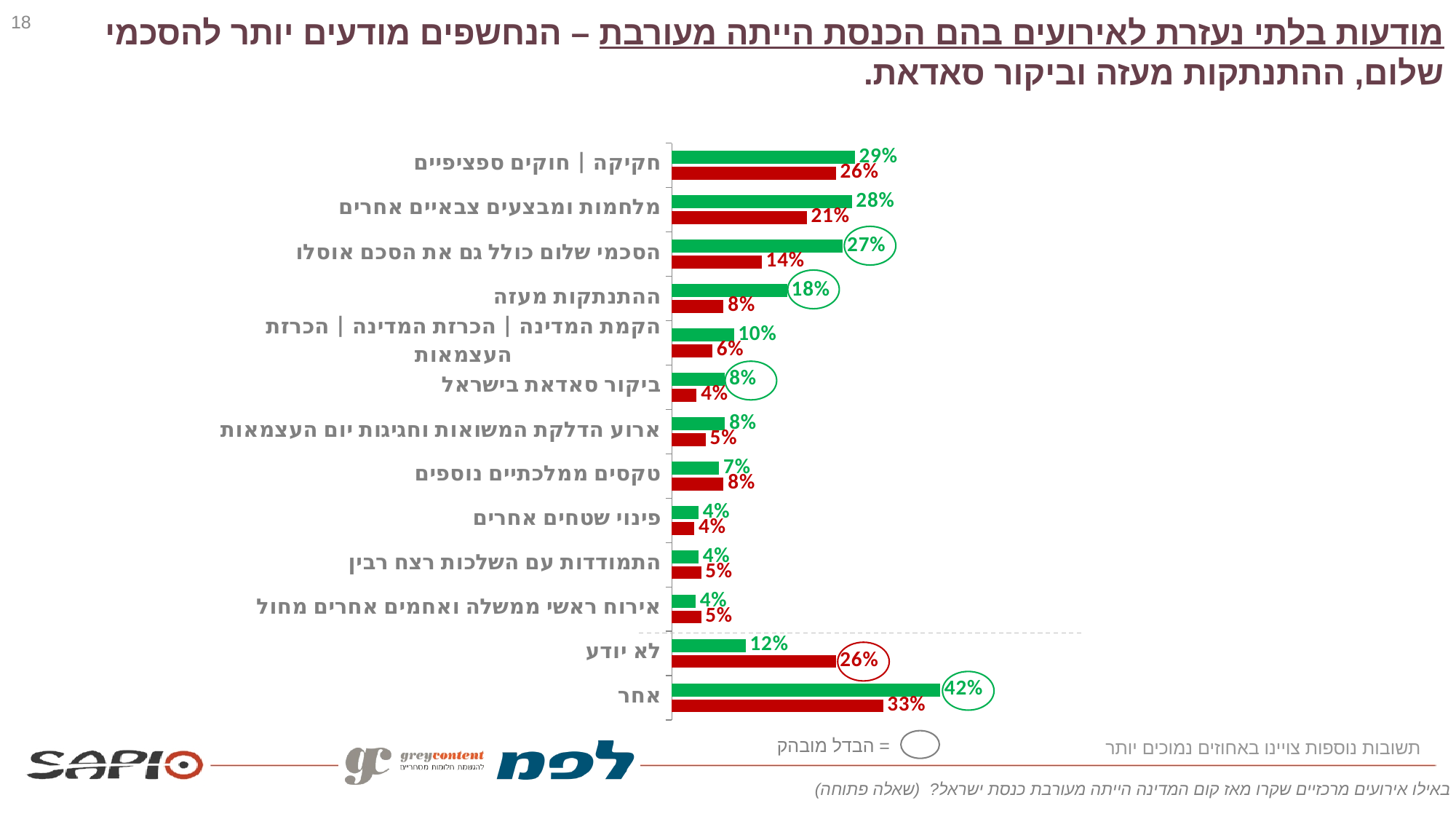
How many categories are shown in the chart? 13 For "לא יודע", which bar is larger, the green or the red? red What is the value of the red bar for "לא יודע"? 26% What is the difference between the green and red bar values for "מלחמות ומבצעים צבאיים אחרים"? 7% For "טקסים ממלכתיים נוספים", which bar is larger, the green or the red? red What type of chart is shown on the slide? bar chart What is the value of the red bar for "ההתנתקות מעזה"? 8% What is the difference between the green and red bar values for "הסכמי שלום כולל גם את הסכם אוסלו"? 13% What is the value of the green bar for "ביקור סאדאת בישראל"? 8% What is the value of the green bar for "הסכמי שלום כולל גם את הסכם אוסלו"? 27% What is the value of the green bar for "חקיקה | חוקים ספציפיים"? 29% Which category has the highest green bar value? אחר